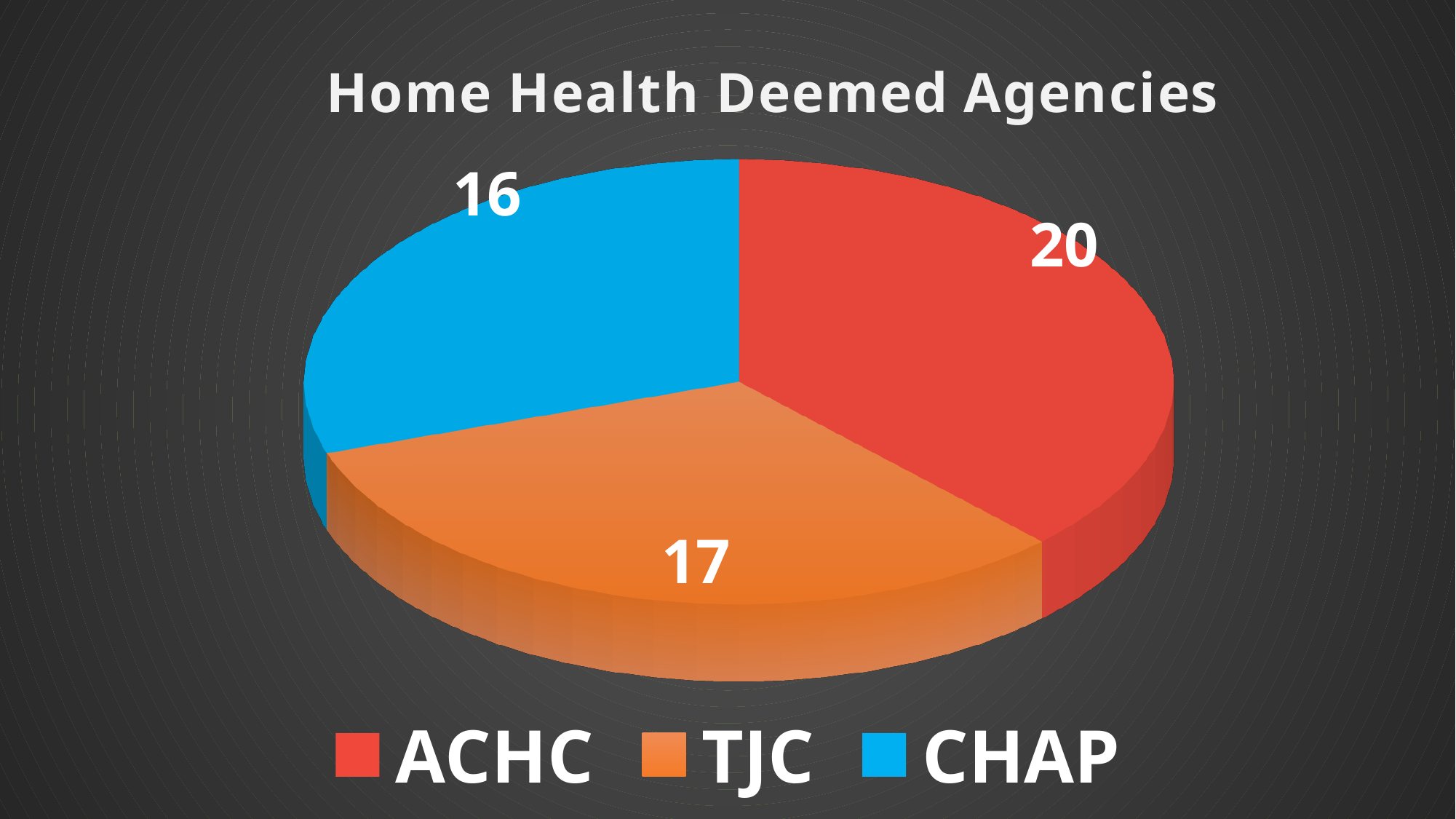
What is the difference between the values for ACHC and CHAP? 4 What is the title of the chart? Home Health Deemed Agencies What is the value for TJC? 17 Which category has the lowest value? CHAP How many categories are shown in the pie chart? 3 What is the value for CHAP? 16 Which is larger, the value for TJC or the value for CHAP? TJC What is the total of all slices in the pie chart? 53 What is the difference between the values for ACHC and TJC? 3 Which category has the highest value? ACHC What kind of chart is shown on the slide? Pie chart What is the value for ACHC? 20